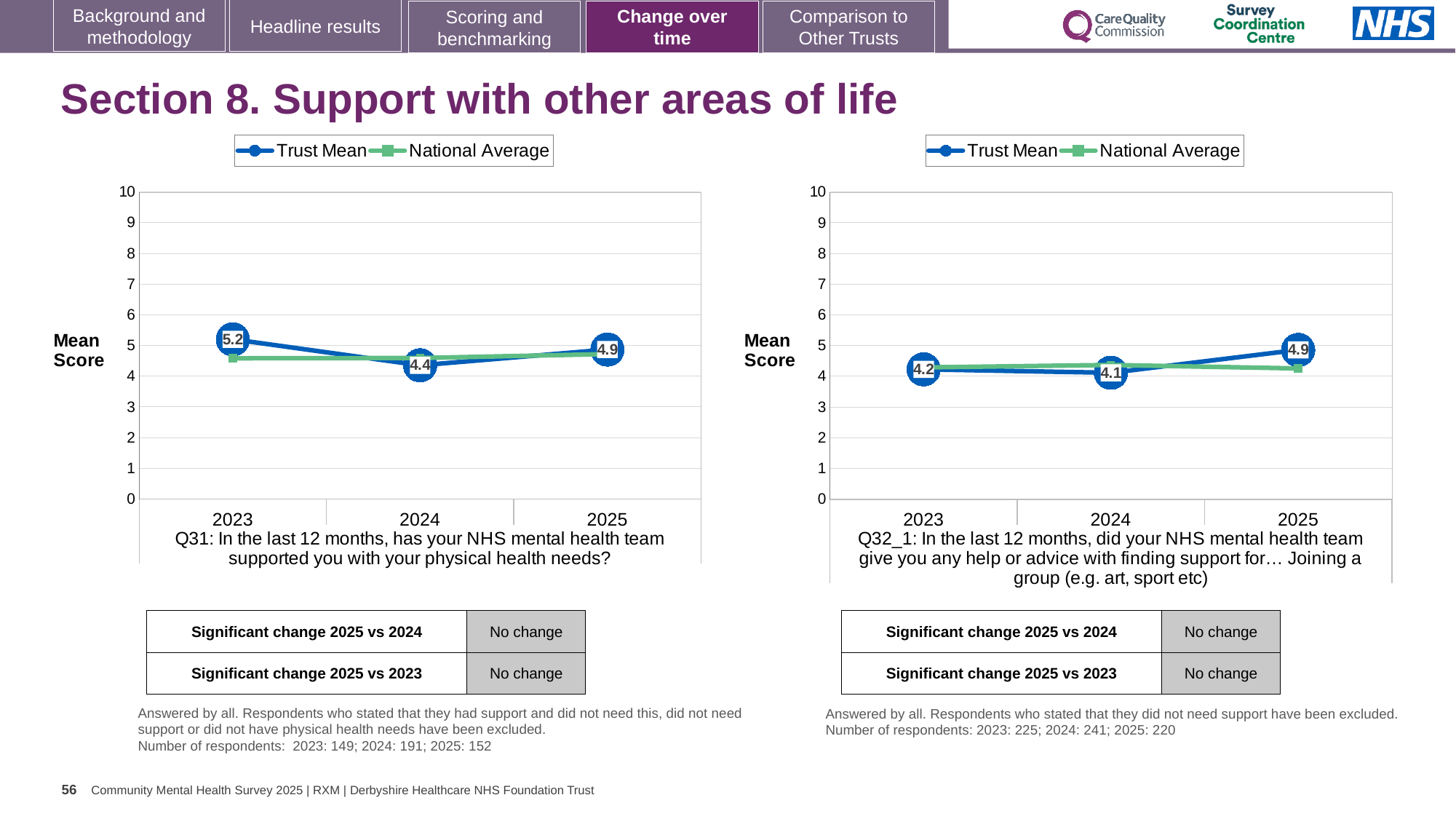
In the Q31 chart on the left, is the National Average for 2023 greater or less than 6? less How many series does the legend of the Q31 chart on the left list? 2 In the Q32_1 chart on the right, what is the Trust Mean for 2024? 4.1 What type of chart is the Q32_1 chart on the right? Line chart In the Q32_1 chart on the right, what is the Trust Mean for 2025? 4.9 In the Q32_1 chart on the right, is the Trust Mean higher in 2025 or in 2023? 2025 In the Q31 chart on the left, what is the Trust Mean for 2023? 5.2 In the Q31 chart on the left, what is the Trust Mean for 2024? 4.4 In the Q31 chart on the left, what is the difference between the Trust Mean in 2023 and 2024? 0.8 In the Q32_1 chart on the right, which year has the lowest Trust Mean? 2024 In the Q31 chart on the left, which year has the highest Trust Mean? 2023 How many years are plotted on the x axis of the Q32_1 chart on the right? 3